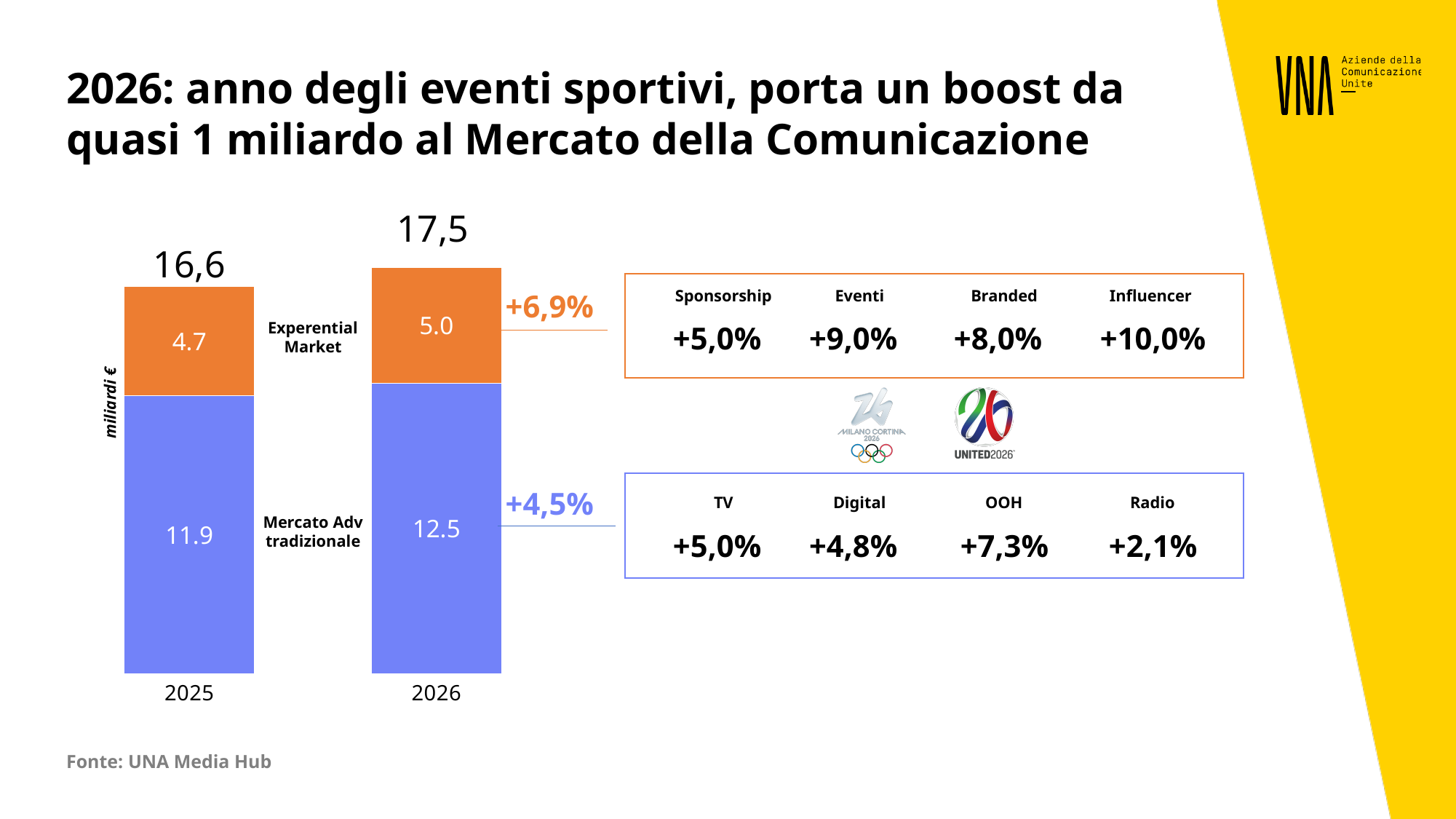
How many years (categories) are shown on the x axis of the chart? 2 What growth percentage is shown next to the Experential Market segment for 2026? +6,9% What kind of chart is shown on the slide? Stacked bar chart What is the total shown above the 2026 stacked bar? 17,5 What is the total shown above the 2025 stacked bar? 16,6 What is the value of Experential Market in 2026? 5.0 Which year has the higher Experential Market value, 2025 or 2026? 2026 How many series are stacked in each bar of the chart? 2 Does the total market value rise or fall from 2025 to 2026? Rise What is the value of Mercato Adv tradizionale in 2025? 11.9 Which segment is larger in 2025, Experential Market or Mercato Adv tradizionale? Mercato Adv tradizionale What is the difference between the Mercato Adv tradizionale values for 2026 and 2025? 0.6